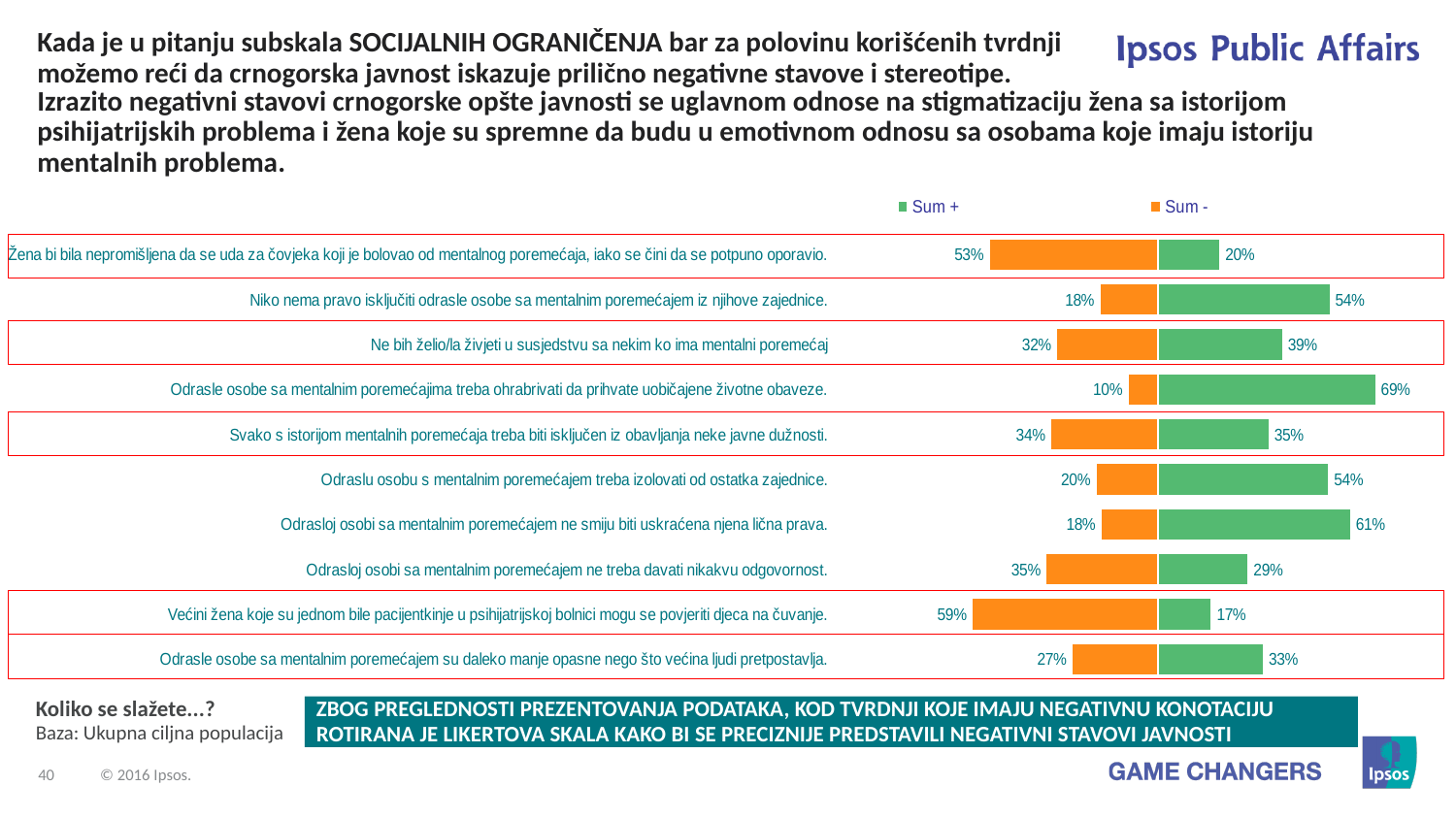
Which statement has the lowest orange (Sum -) value? Odrasle osobe sa mentalnim poremećajima treba ohrabrivati da prihvate uobičajene životne obaveze. Which colour represents the 'Sum -' series in the legend? orange How many statements (categories) are plotted in the chart? 10 What is the difference between the green (Sum +) and orange (Sum -) values for the statement 'Niko nema pravo isključiti odrasle osobe sa mentalnim poremećajem iz njihove zajednice.'? 36% How many series does the legend list? 2 What is the green (Sum +) value for the statement 'Odrasle osobe sa mentalnim poremećajima treba ohrabrivati da prihvate uobičajene životne obaveze.'? 69% Which statement has the highest green (Sum +) value? Odrasle osobe sa mentalnim poremećajima treba ohrabrivati da prihvate uobičajene životne obaveze. What is the green (Sum +) value for the statement 'Odrasloj osobi sa mentalnim poremećajem ne smiju biti uskraćena njena lična prava.'? 61% What is the orange (Sum -) value for the statement 'Većini žena koje su jednom bile pacijentkinje u psihijatrijskoj bolnici mogu se povjeriti djeca na čuvanje.'? 59% For the statement 'Odrasloj osobi sa mentalnim poremećajem ne treba davati nikakvu odgovornost.', which is larger, the orange (Sum -) value or the green (Sum +) value? the orange (Sum -) value What kind of chart is shown on the slide? bar chart What is the green (Sum +) value for the statement 'Žena bi bila nepromišljena da se uda za čovjeka koji je bolovao od mentalnog poremećaja, iako se čini da se potpuno oporavio.'? 20%